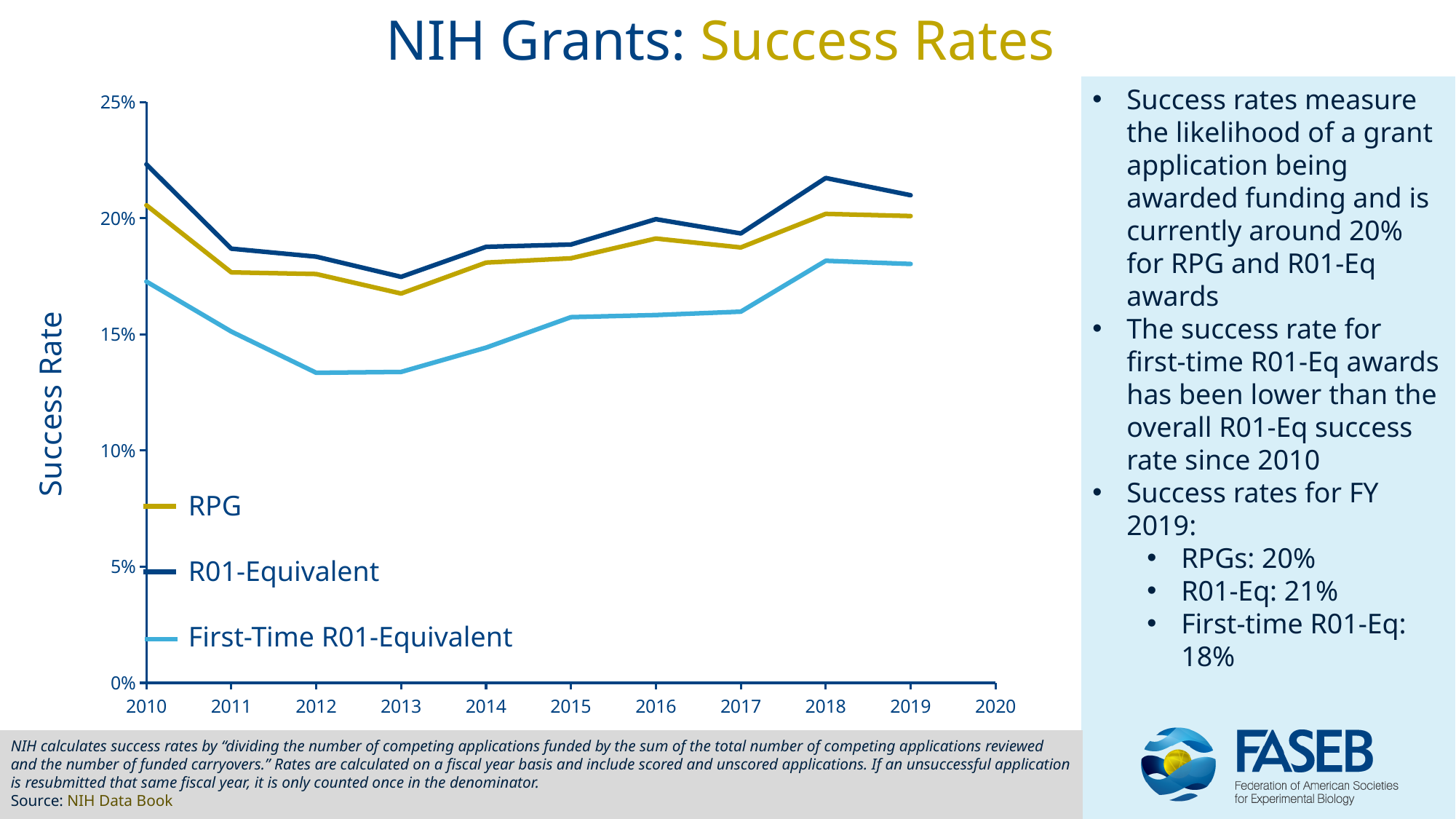
According to the slide, what was the FY 2019 success rate for RPGs? 20% Is the R01-Equivalent success rate in 2010 greater or less than 20%? greater How many years have data points plotted on the chart? 10 What kind of chart is shown on the slide? line chart Which series has the lowest success rate across all years shown? First-Time R01-Equivalent What is the label on the chart's vertical axis? Success Rate According to the slide, what was the FY 2019 success rate for First-Time R01-Equivalent awards? 18% Does the First-Time R01-Equivalent success rate rise or fall from 2013 to 2018? rise Which series has the highest success rate in 2010? R01-Equivalent Is the First-Time R01-Equivalent success rate in 2012 greater or less than 15%? less According to the slide, what was the FY 2019 success rate for R01-Equivalent awards? 21% How many series does the chart's legend list? 3